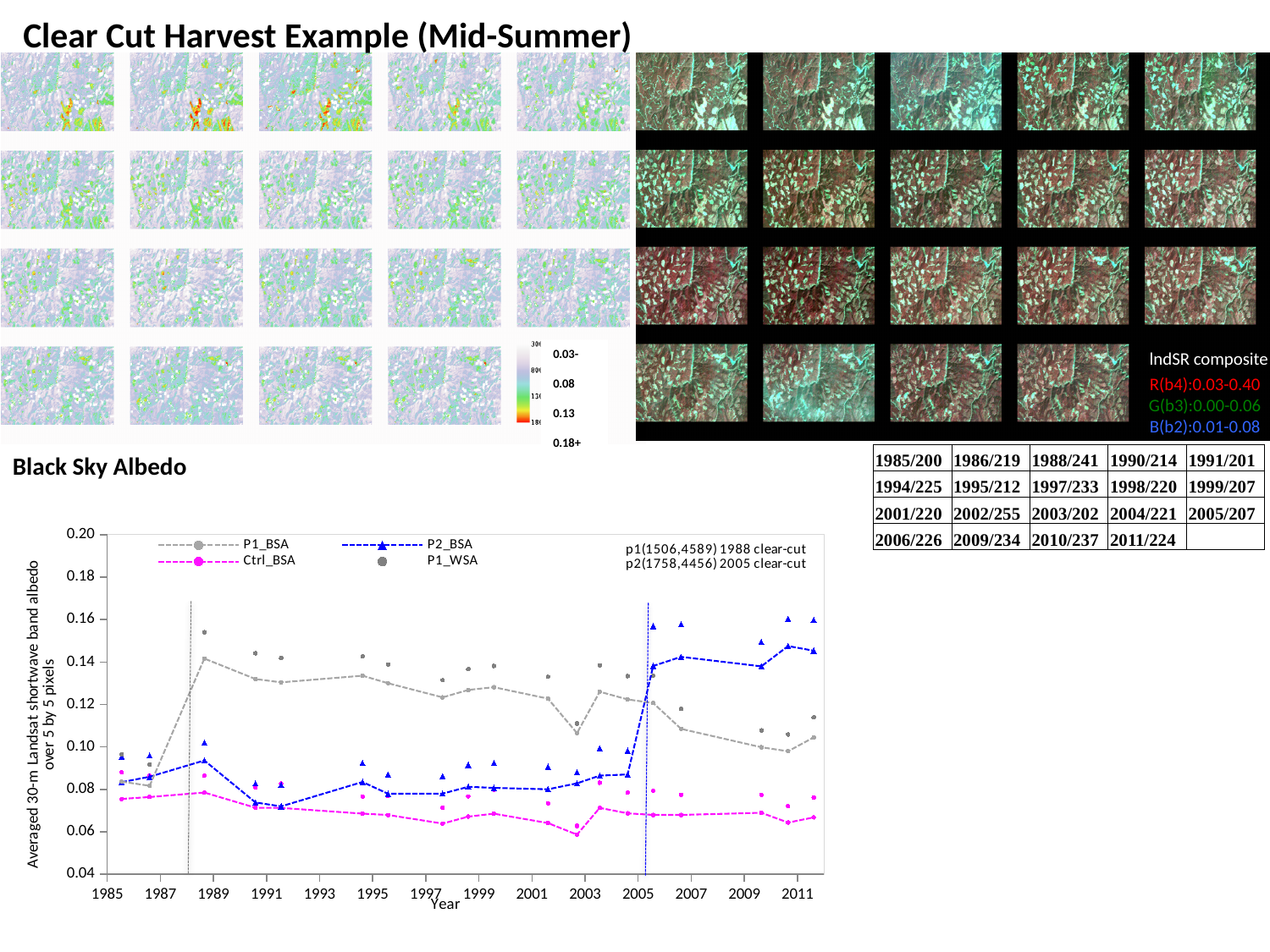
In the Black Sky Albedo chart, which series has the lowest values across the whole period? Ctrl_BSA In the Black Sky Albedo chart, is the P1_BSA value in 1989 greater or less than 0.12? greater What kind of chart is the Black Sky Albedo chart? line chart In the Black Sky Albedo chart, which is larger in 1995, P1_BSA or P2_BSA? P1_BSA In the Black Sky Albedo chart, does the P1_BSA line rise or fall from 1989 to 2011? fall In the Black Sky Albedo chart, which is larger in 2011, P2_BSA or P1_BSA? P2_BSA In the Black Sky Albedo chart, is the P2_BSA value in 2007 greater or less than 0.12? greater In the Black Sky Albedo chart, is the P2_BSA value in 1995 greater or less than 0.10? less How many series does the legend of the Black Sky Albedo chart list? 4 What is the label of the x axis on the Black Sky Albedo chart? Year Which series in the Black Sky Albedo chart is drawn in magenta? Ctrl_BSA